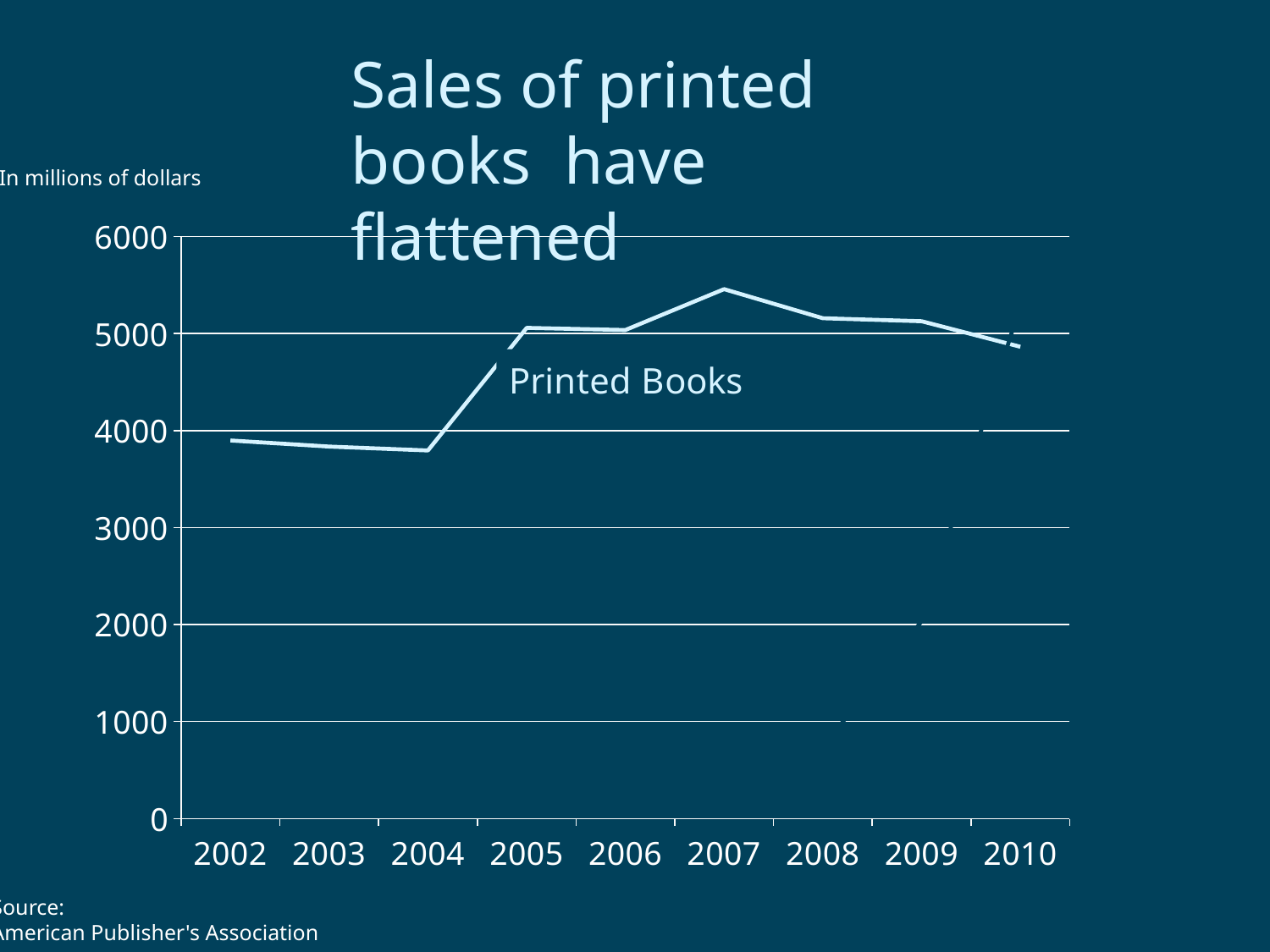
Which year has the highest value for Printed Books? 2007 Which year has the larger value for Printed Books, 2007 or 2010? 2007 What unit is stated for the values on the chart? In millions of dollars What is the title of the chart? Sales of printed books have flattened Is the value for Printed Books in 2010 greater or less than 5000? less Is the value for Printed Books in 2002 greater or less than 4000? less Is the value for Printed Books in 2007 greater or less than 5000? greater Which year has the lowest value for Printed Books? 2004 Do the values for Printed Books rise or fall from 2007 to 2010? fall What kind of chart is shown on the slide? line chart How many years are plotted along the x axis? 9